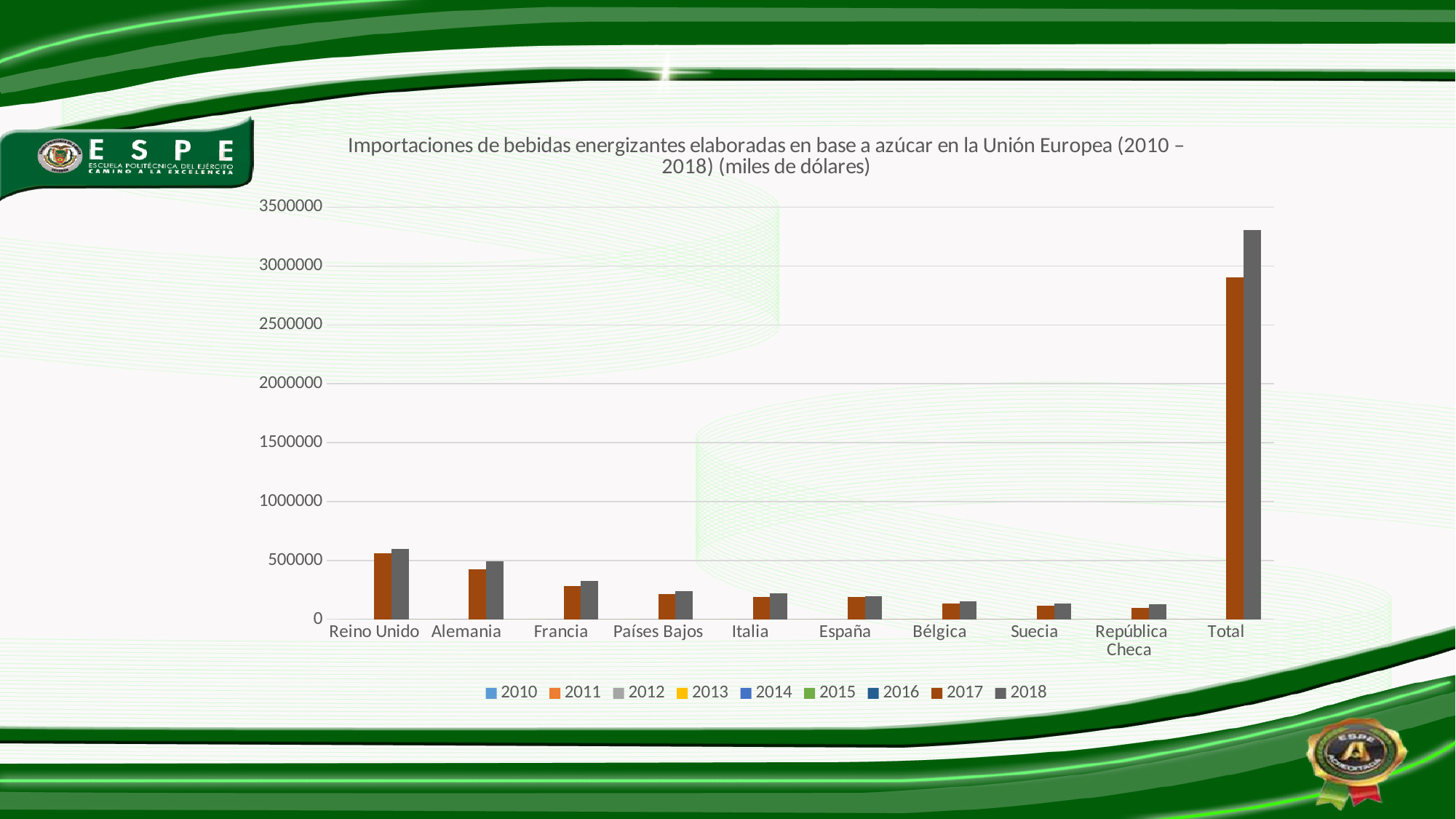
For Francia, which year has the larger value, 2017 or 2018? 2018 Which category has the tallest 2018 bar? Total Is the 2017 value for Alemania greater or less than 500000? less Which category has the shortest 2017 bar? República Checa How many series does the legend list? 9 Is the 2018 value for Reino Unido greater or less than 500000? greater Which has the larger 2018 value, Reino Unido or Alemania? Reino Unido How many categories are shown on the x axis? 10 Among the individual countries (excluding Total), which has the tallest 2018 bar? Reino Unido Is the 2017 value for Total greater or less than 3000000? less What type of chart is shown on the slide? bar chart